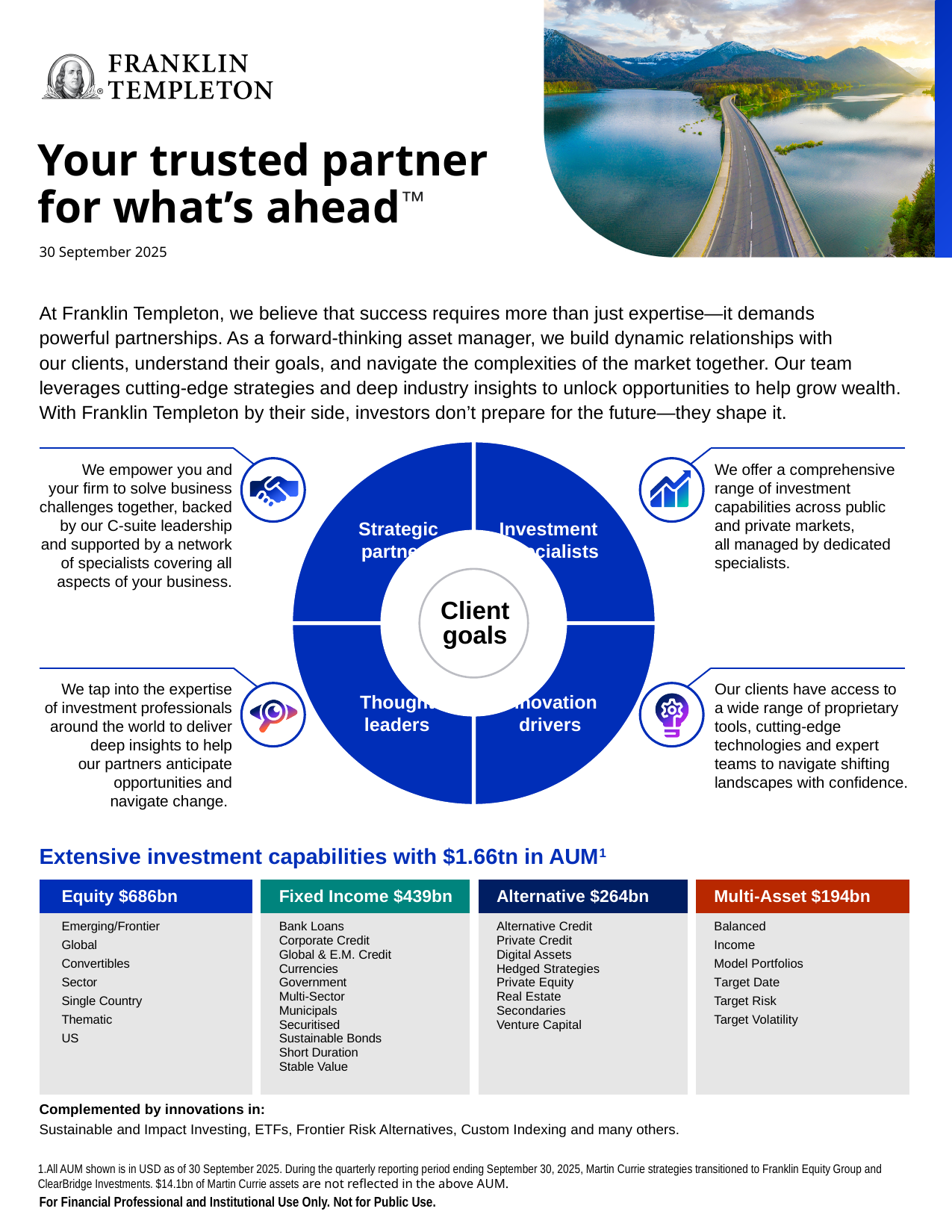
In the investment capabilities section, what is the AUM shown for Alternative? $264bn What total AUM figure is stated in the heading of the investment capabilities section? $1.66tn How many asset class boxes are shown in the investment capabilities section? 4 In the investment capabilities section, which asset class has the highest AUM? Equity In the investment capabilities section, which asset class has the lowest AUM? Multi-Asset In the investment capabilities section, which has the larger AUM, Fixed Income or Alternative? Fixed Income In the investment capabilities section, what is the AUM shown for Fixed Income? $439bn In the investment capabilities section, what is the AUM shown for Multi-Asset? $194bn In the investment capabilities section, what is the AUM shown for Equity? $686bn In the investment capabilities section, what is the difference in AUM between Equity and Fixed Income? $247bn In the circular diagram, what label appears in the centre circle? Client goals In the investment capabilities section, what is the difference in AUM between Alternative and Multi-Asset? $70bn